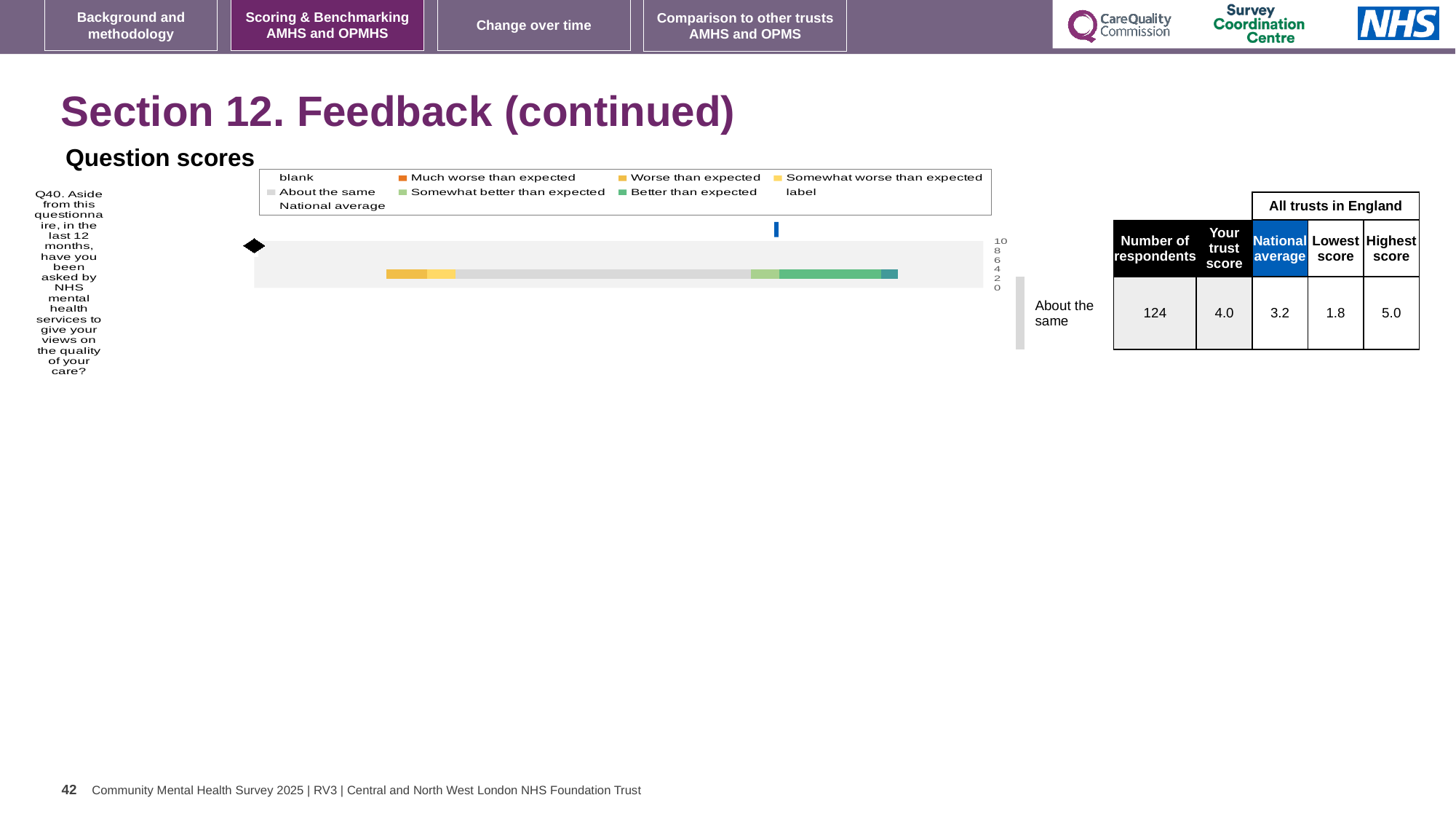
Which question is plotted in the Question scores chart? Q40 What is the highest value shown on the chart's axis? 10 How many questions (categories) are plotted in the Question scores chart? 1 What kind of chart is used to show the Q40 question score? bar chart In the table beside the chart, which is larger for Q40: the trust's score or the national average? the trust's score In the table beside the chart, what is the highest score among all trusts in England for Q40? 5.0 In the table beside the chart, what is the trust's score for Q40? 4.0 In the table beside the chart, what is the national average score for Q40? 3.2 In the chart legend, which entry is shown in orange? Much worse than expected According to the label beside the chart, how is the trust's result for Q40 categorised? About the same In the table beside the chart, what is the lowest score among all trusts in England for Q40? 1.8 In the table beside the chart, what is the number of respondents for Q40? 124